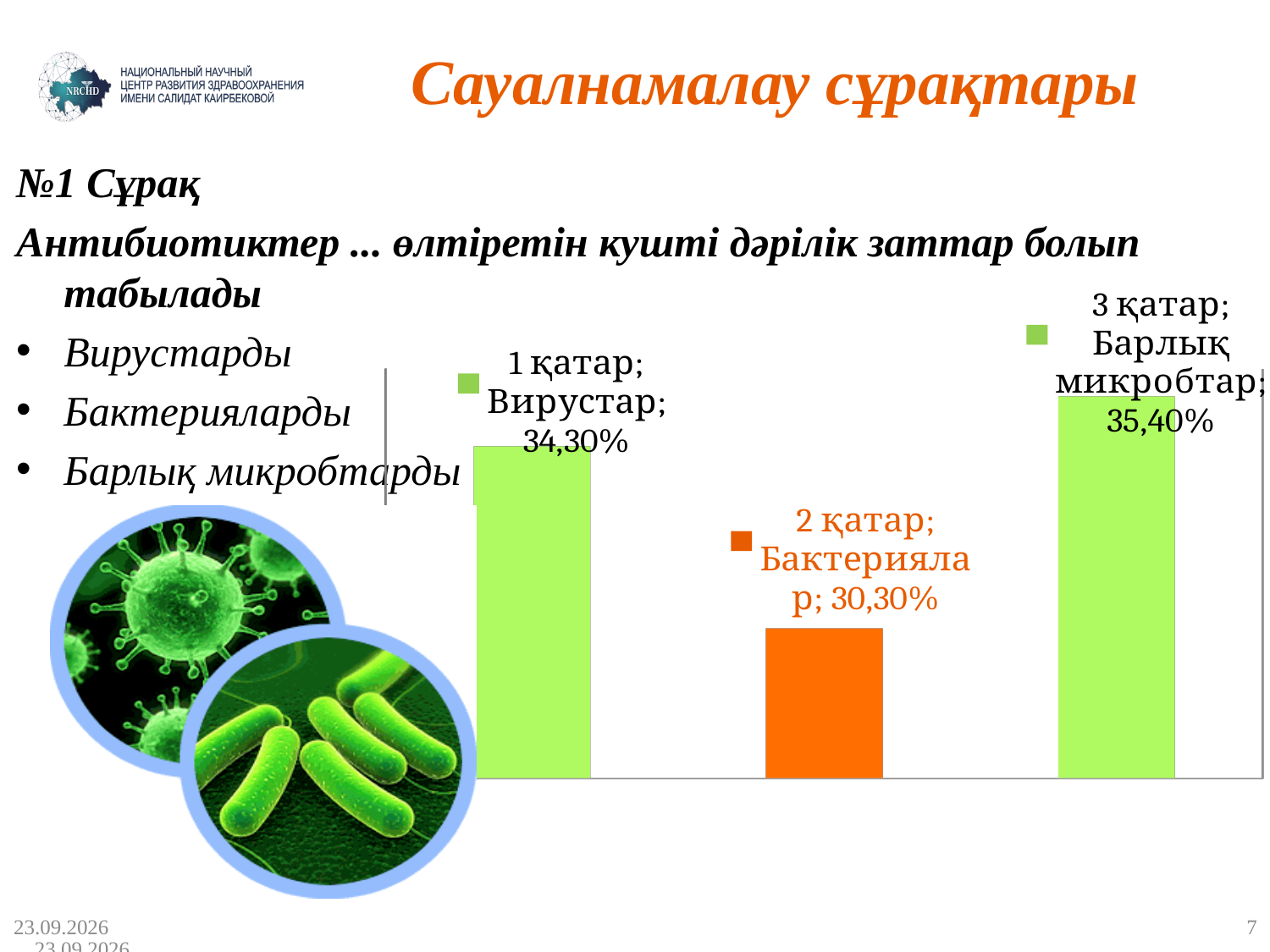
How many bars are shown in the chart? 3 Which is larger, the value for Вирустар or the value for Бактериялар? Вирустар What is the difference between the values for Барлық микробтар and Бактериялар? 5,10% What is the value shown for Бактериялар? 30,30% What is the value shown for Вирустар? 34,30% What kind of chart is shown on the slide? Bar chart What is the value shown for Барлық микробтар? 35,40% Which data label is attached to the bar labelled '2 қатар'? Бактериялар; 30,30% Which category has the highest value? Барлық микробтар What colour is the bar for Бактериялар? Orange Which category has the lowest value? Бактериялар What is the difference between the values for Вирустар and Бактериялар? 4,00%